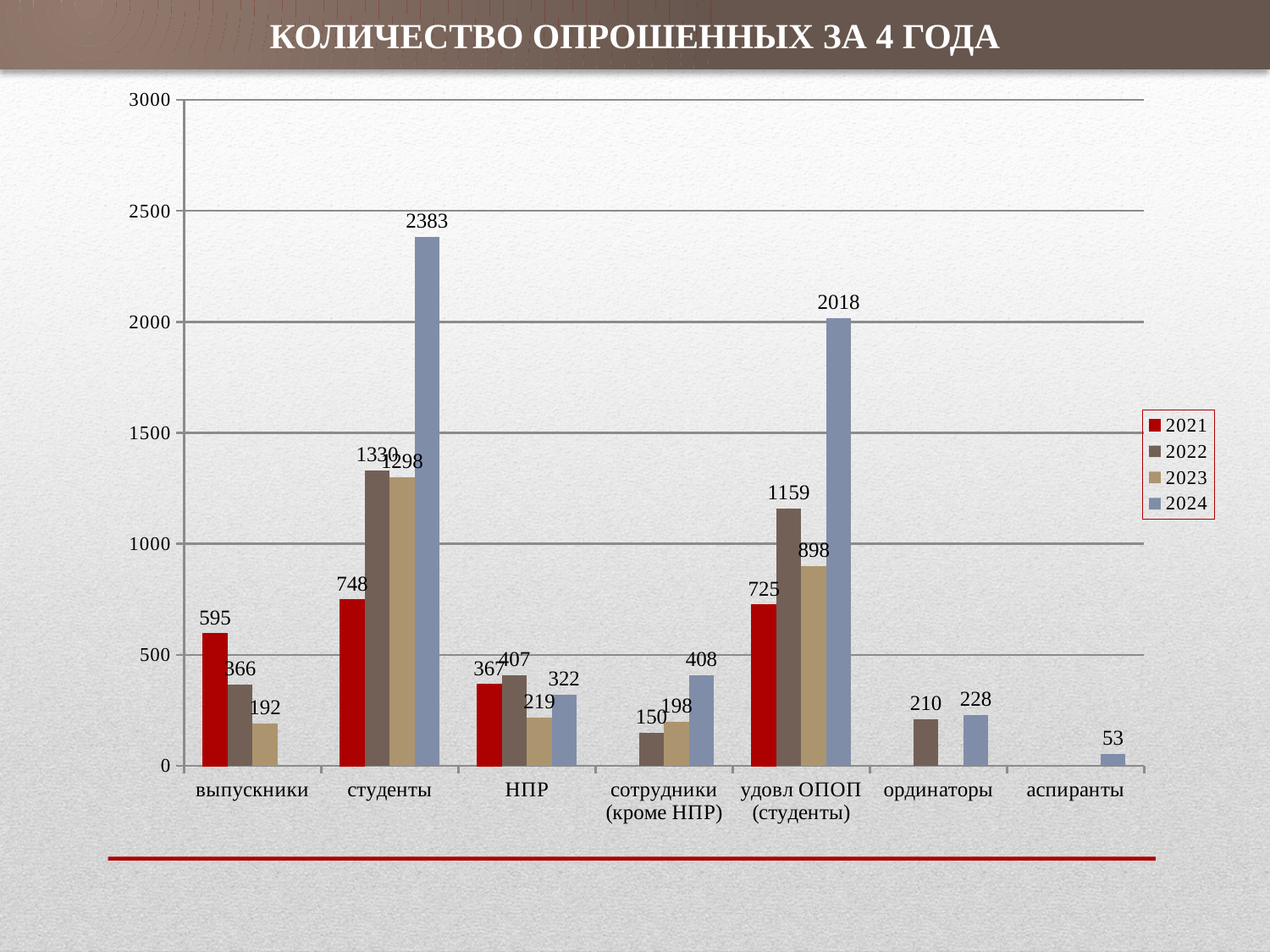
Which category has the lowest value in 2024? аспиранты Which is larger for НПР: the 2022 value or the 2024 value? 2022 How many series does the legend list? 4 What kind of chart is shown on the slide? bar chart Is the value for удовл ОПОП (студенты) in 2024 greater or less than 2000? greater How many categories are shown on the x axis? 7 Which category has the highest value in 2024? студенты What is the value for аспиранты in 2024? 53 What is the value for студенты in 2024? 2383 What is the value for удовл ОПОП (студенты) in 2022? 1159 What is the value for выпускники in 2021? 595 What is the difference between the 2024 and 2023 values for студенты? 1085